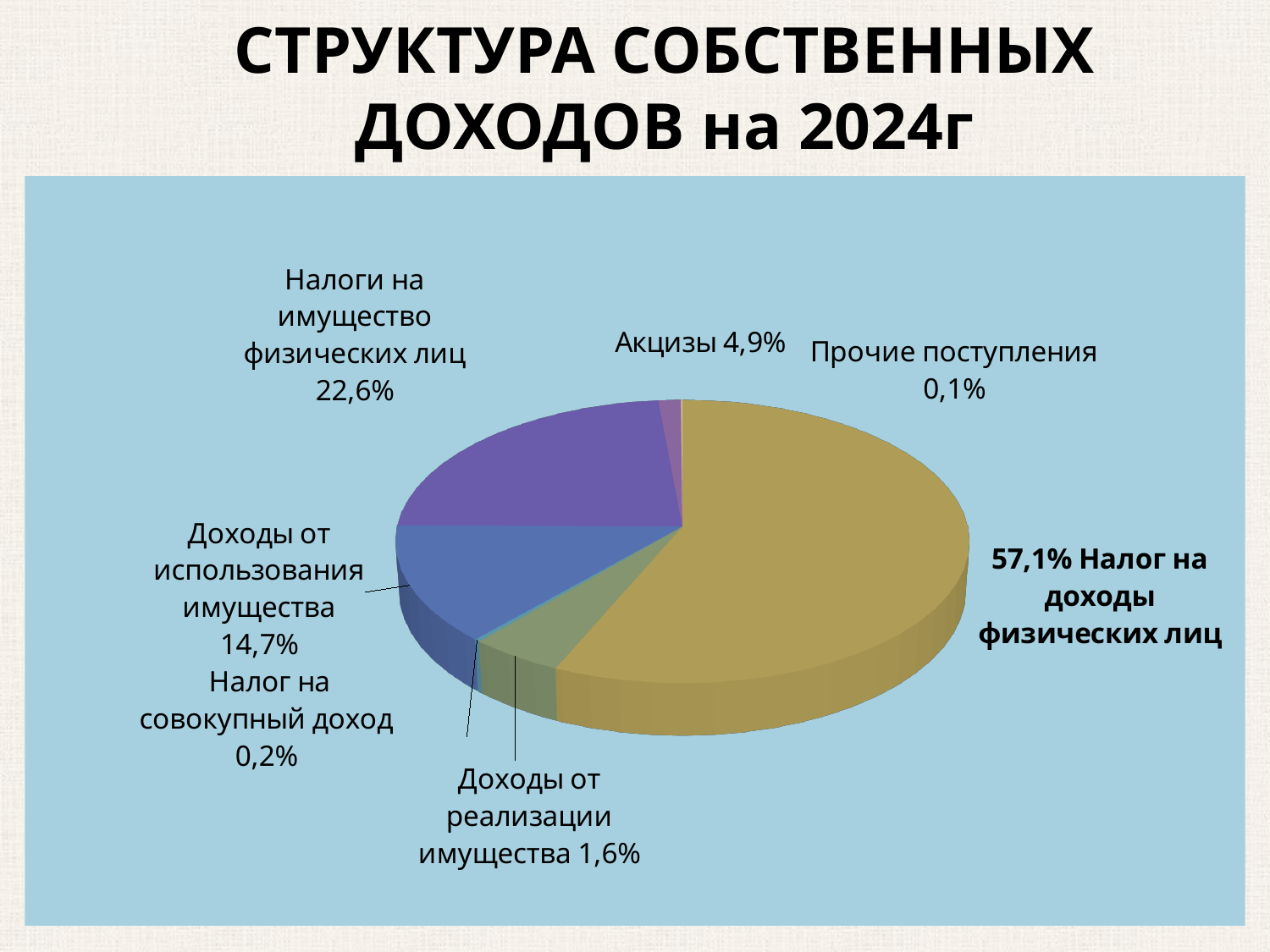
Which category has the smallest share of the pie? Прочие поступления What kind of chart is shown on the slide? Pie chart Which category has the largest share of the pie? Налог на доходы физических лиц What share of own revenues does "Налог на доходы физических лиц" account for? 57,1% Which is larger: the share of "Акцизы" or the share of "Доходы от реализации имущества"? Акцизы What is the value shown for "Доходы от использования имущества"? 14,7% What is the value shown for "Акцизы"? 4,9% What is the value shown for "Прочие поступления"? 0,1% What is the title of the slide? СТРУКТУРА СОБСТВЕННЫХ ДОХОДОВ на 2024г How many categories are shown in the pie chart? 7 What is the difference between the shares of "Налоги на имущество физических лиц" and "Доходы от использования имущества"? 7,9% What is the value shown for "Налоги на имущество физических лиц"? 22,6%